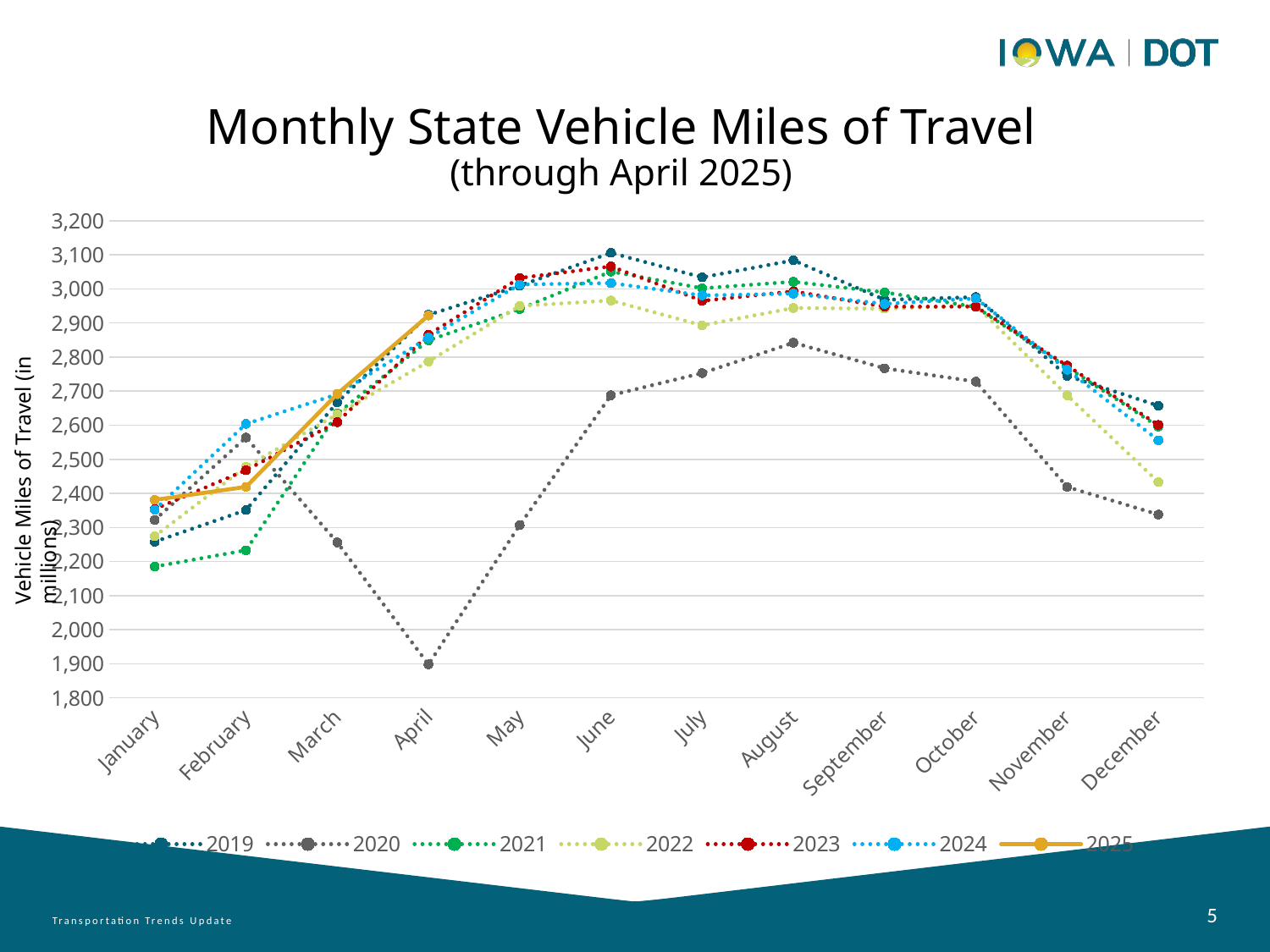
Which year's series has the lowest value in April? 2020 What kind of chart is shown on the slide? line chart What is the label on the vertical axis? Vehicle Miles of Travel (in millions) Which year's series has the highest value in June? 2019 Does the 2025 series rise or fall from January to April? rise Which is larger in August, the value for 2019 or the value for 2020? 2019 How many series does the legend list? 7 Which year's series has the lowest value in December? 2020 How many months are shown along the x axis? 12 Is the value for 2020 in April greater or less than 2,000? less Is the value for 2022 in December greater or less than 2,500? less Is the value for 2019 in June greater or less than 3,000? greater